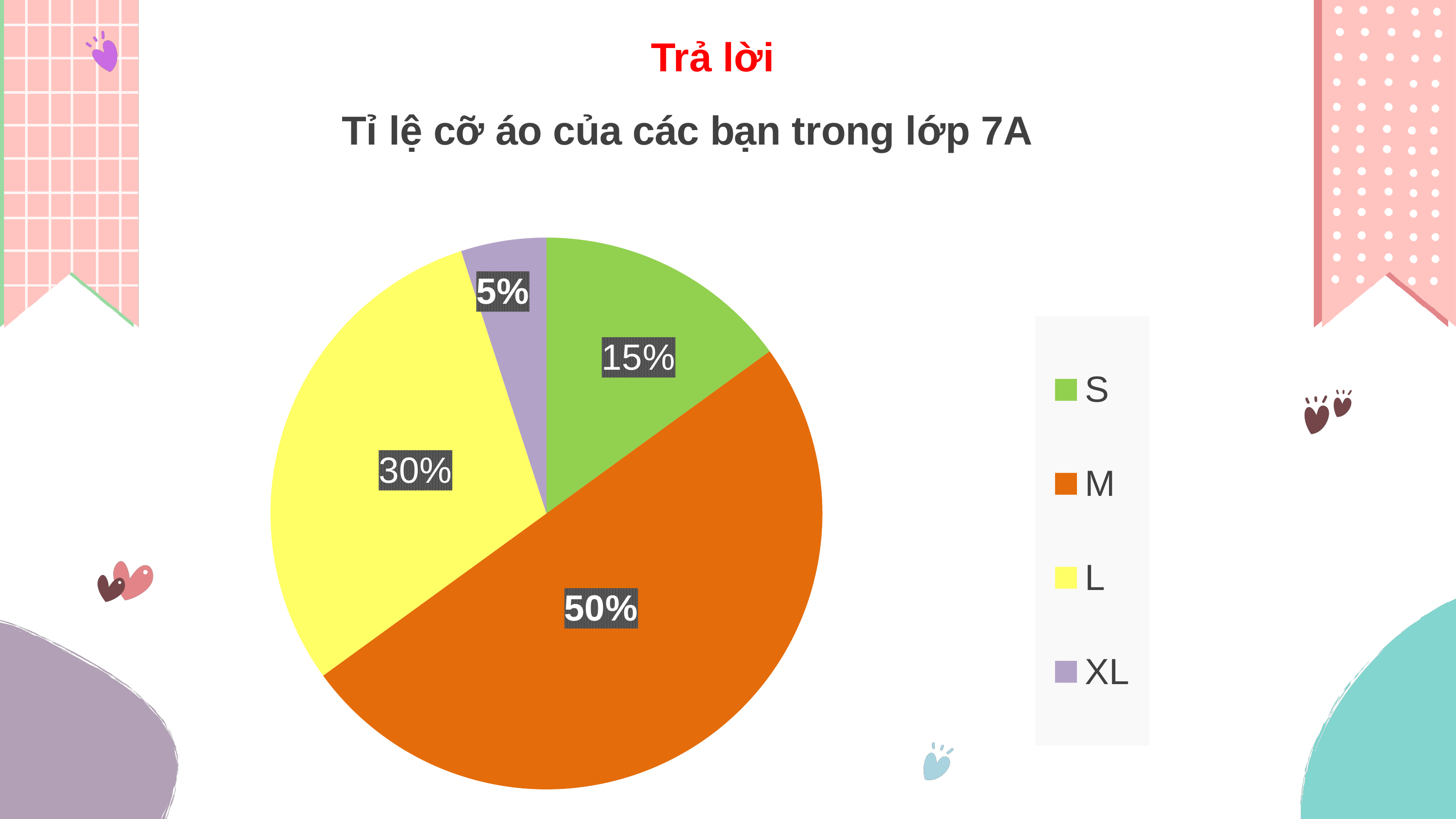
What percentage of the pie chart is size L? 30% What is the difference in percentage points between size S and size XL? 10 What percentage of the pie chart is size M? 50% What type of chart is shown on the slide? pie chart Which shirt size has the largest share of the pie chart? M Which has a larger share, size S or size L? L What percentage of the pie chart is size XL? 5% Which shirt size has the smallest share of the pie chart? XL What percentage of the pie chart is size S? 15% How many shirt sizes are shown in the pie chart? 4 What is the difference in percentage points between size M and size L? 20 What colour represents size L in the pie chart? yellow